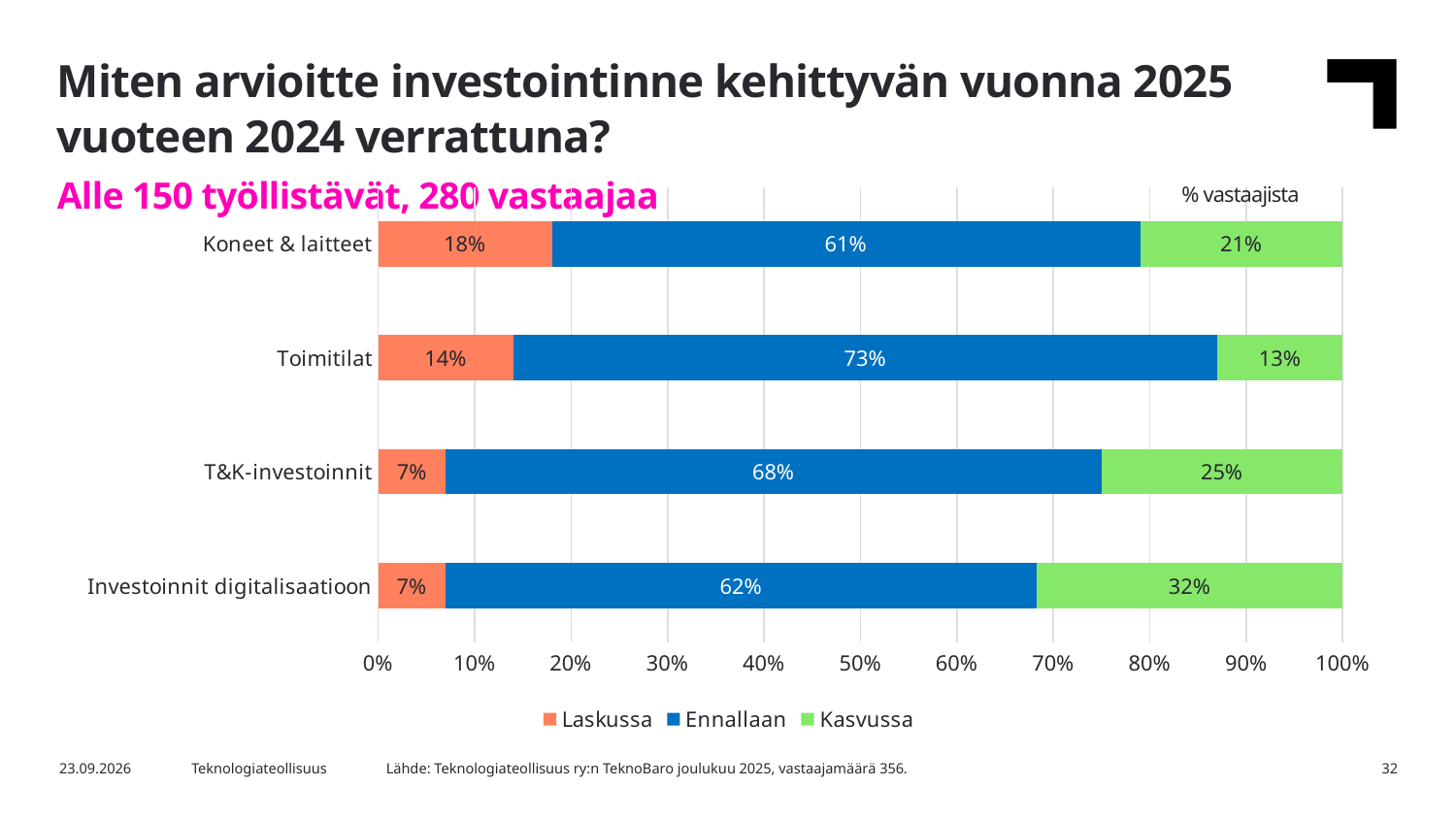
What is the Kasvussa value for Investoinnit digitalisaatioon? 32% How many series does the legend list? 3 How many categories are shown on the chart? 4 Which series is shown in green in the legend? Kasvussa Which is larger, the Laskussa value for Koneet & laitteet or for Toimitilat? Koneet & laitteet What is the Ennallaan value for Toimitilat? 73% What is the Laskussa value for Koneet & laitteet? 18% What kind of chart is shown on the slide? Stacked bar chart What is the total of the stacked bar for T&K-investoinnit? 100% Which category has the highest Kasvussa value? Investoinnit digitalisaatioon Which category has the lowest Kasvussa value? Toimitilat What is the difference between the Ennallaan values for Toimitilat and Koneet & laitteet? 12%